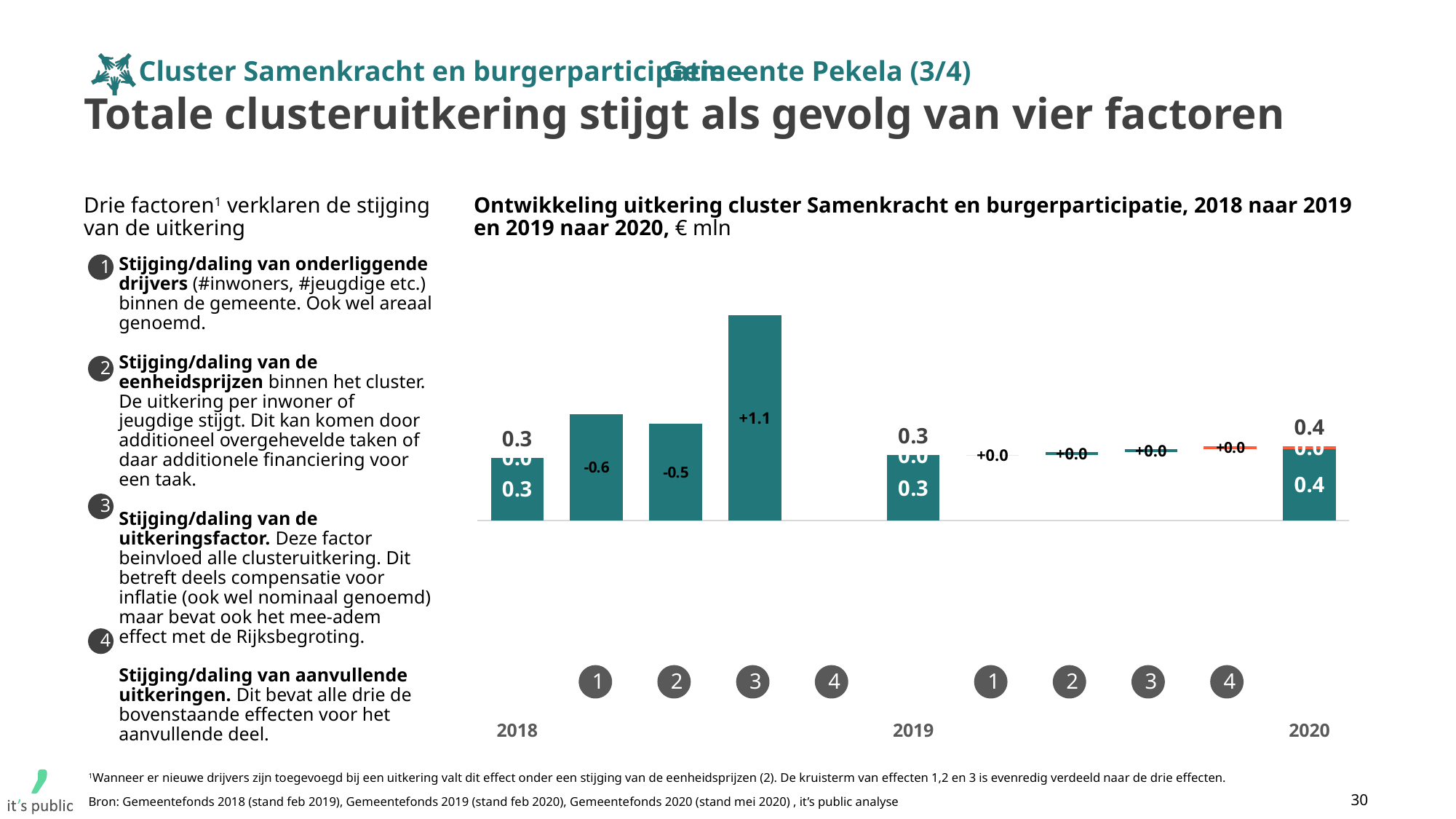
Is the value of factor 3 (2018 to 2019) larger than the value of factor 2 (2018 to 2019)? Yes What is the total value shown for 2019? 0.3 What is the value of factor 2 in the change from 2018 to 2019? -0.5 What is the value of factor 1 in the change from 2019 to 2020? +0.0 What is the total value shown for 2020? 0.4 What is the value of factor 3 in the change from 2018 to 2019? +1.1 What is the value of factor 1 in the change from 2018 to 2019? -0.6 What kind of chart is shown on the slide? Bar chart (waterfall) In what unit are the values in the chart expressed? € mln Which factor has the lowest value in the change from 2018 to 2019? 1 Which factor has the largest value in the change from 2018 to 2019? 3 What is the total value shown for 2018? 0.3